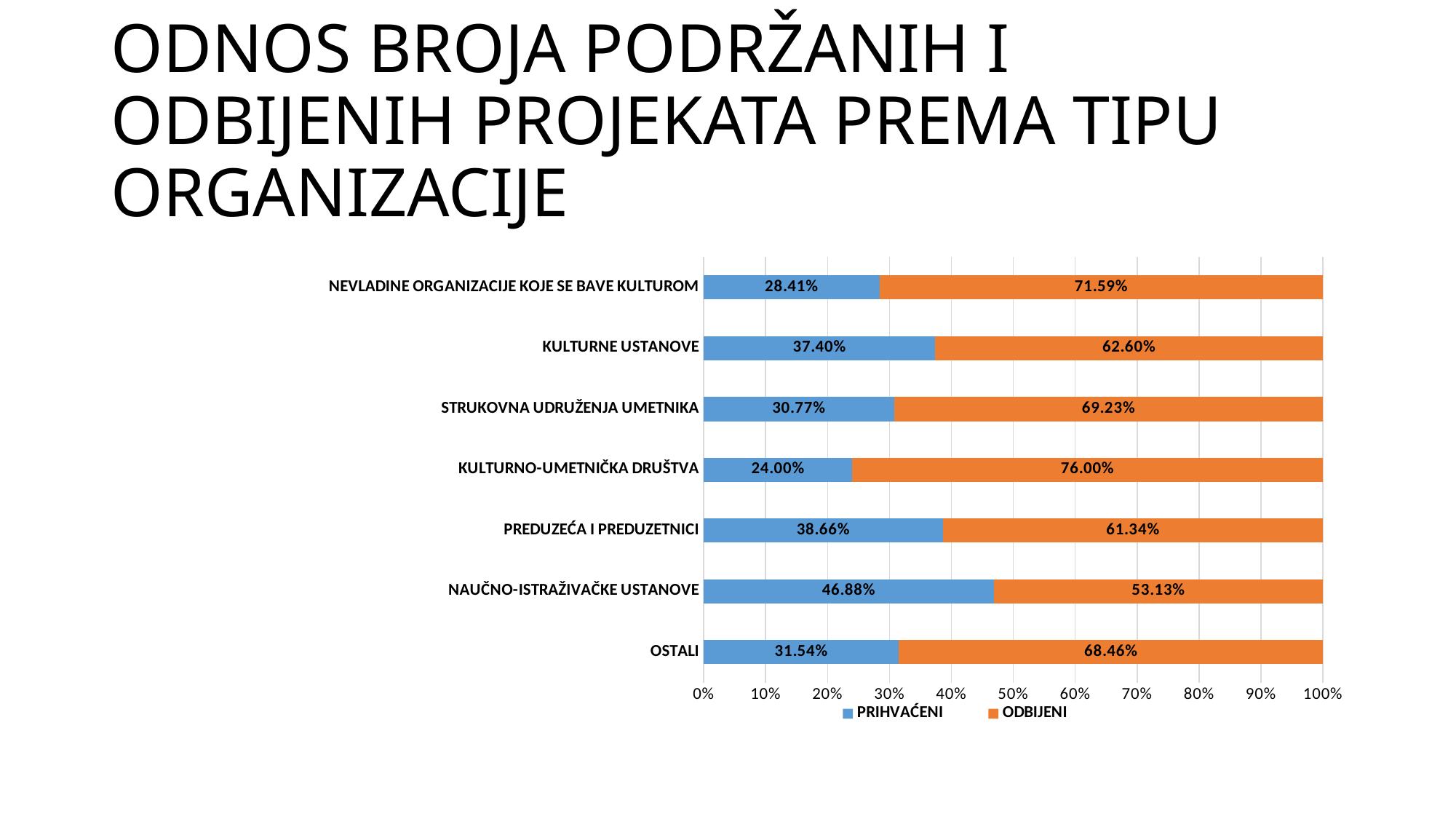
What is the ODBIJENI value for KULTURNO-UMETNIČKA DRUŠTVA? 76.00% Is the PRIHVAĆENI value for NEVLADINE ORGANIZACIJE KOJE SE BAVE KULTUROM greater or less than 30%? less What is the difference between the ODBIJENI value for OSTALI and the PRIHVAĆENI value for OSTALI? 36.92% What is the PRIHVAĆENI value for NAUČNO-ISTRAŽIVAČKE USTANOVE? 46.88% What kind of chart is shown on the slide? Stacked bar chart Which category has the highest PRIHVAĆENI share? NAUČNO-ISTRAŽIVAČKE USTANOVE How many series does the legend list? 2 What is the PRIHVAĆENI value for KULTURNE USTANOVE? 37.40% How many organization types are shown on the chart? 7 Which category has the lowest PRIHVAĆENI share? KULTURNO-UMETNIČKA DRUŠTVA Which is larger: the PRIHVAĆENI value for PREDUZEĆA I PREDUZETNICI or the PRIHVAĆENI value for STRUKOVNA UDRUŽENJA UMETNIKA? PREDUZEĆA I PREDUZETNICI Which category has the highest ODBIJENI share? KULTURNO-UMETNIČKA DRUŠTVA